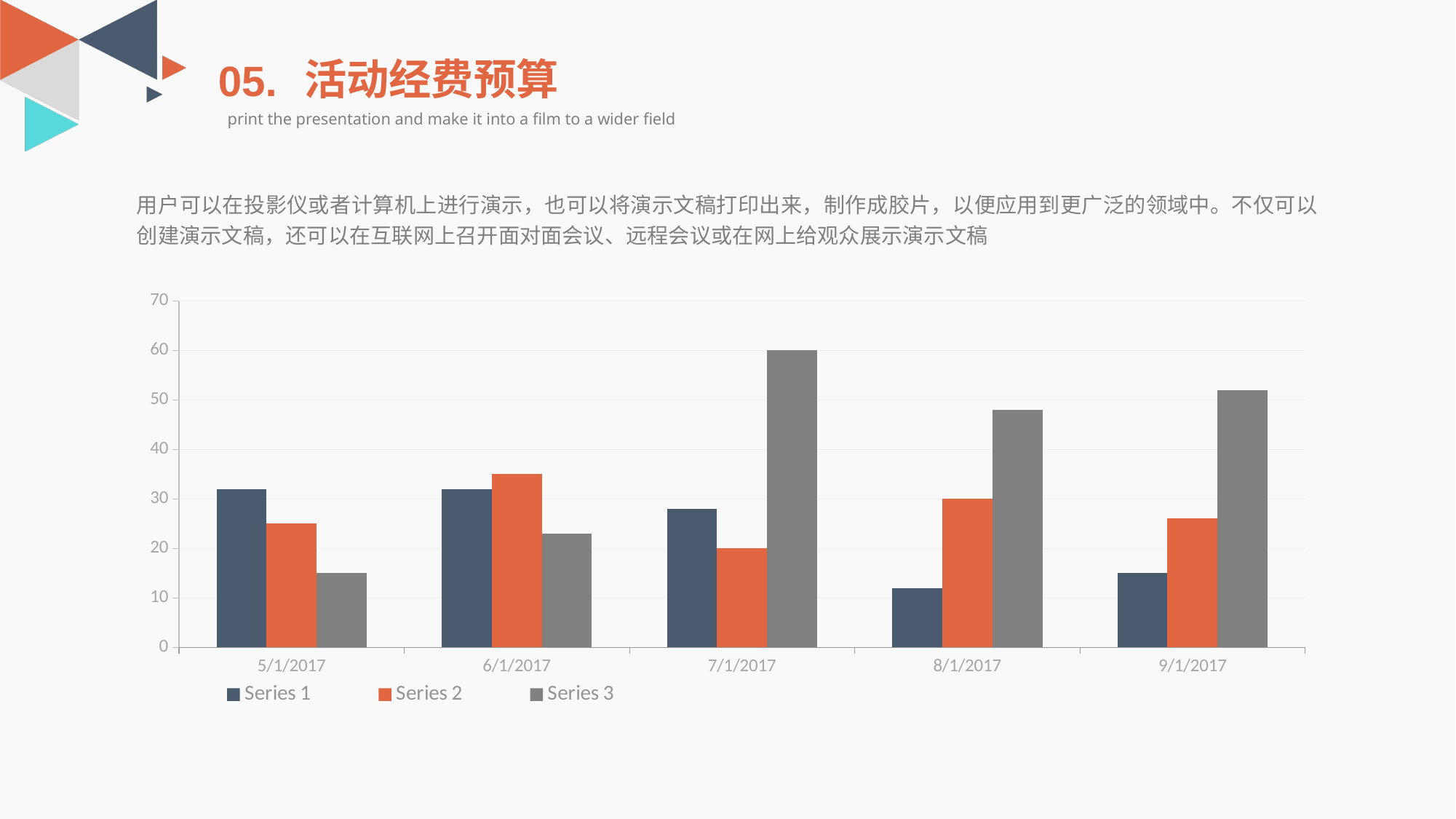
What is the value of Series 3 for 7/1/2017? 60 For which date is the Series 1 bar the lowest? 8/1/2017 Which colour represents Series 2 in the legend? orange For which date is the Series 3 bar the highest? 7/1/2017 What kind of chart is shown on the slide? bar chart Is the value for Series 3 at 5/1/2017 greater or less than 20? less How many date categories are shown on the x axis? 5 Is the value for Series 2 at 6/1/2017 greater or less than 30? greater Is the value for Series 3 at 7/1/2017 greater or less than 50? greater At 7/1/2017, which is larger: Series 1 or Series 3? Series 3 How many series does the legend list? 3